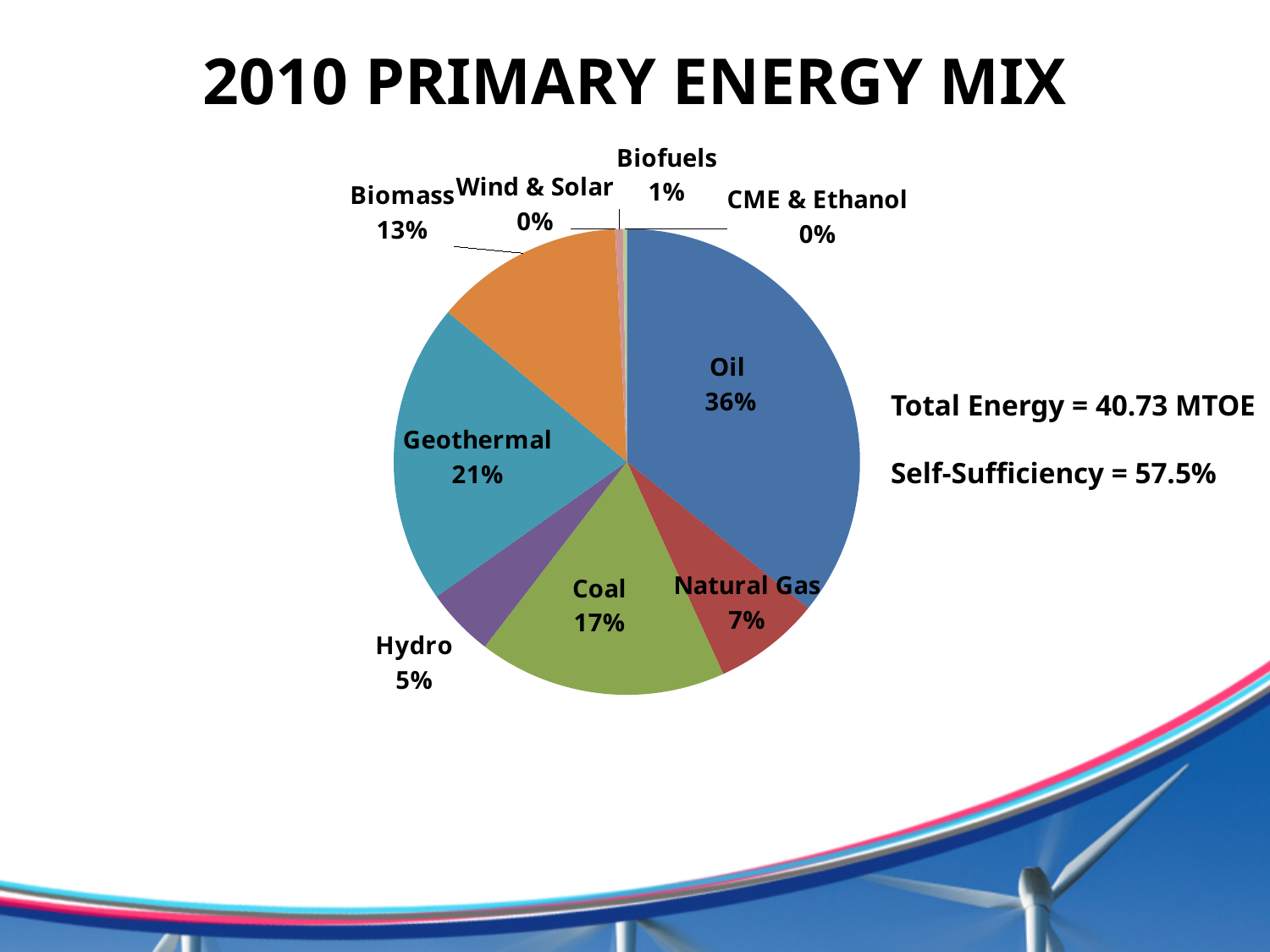
How many categories are labelled on the pie chart? 9 What type of chart is shown on the slide? Pie chart What is the share for Hydro? 5% What percentage is shown for Biomass? 13% What is the difference in percentage points between Oil and Geothermal? 15 What is the title of the chart on the slide? 2010 PRIMARY ENERGY MIX Which energy source has the largest share of the pie? Oil What share of the 2010 primary energy mix does Oil account for? 36% What is the share for Coal? 17% What percentage does Natural Gas represent? 7% Which is larger, the share for Coal or the share for Biomass? Coal What percentage of the pie is Geothermal? 21%